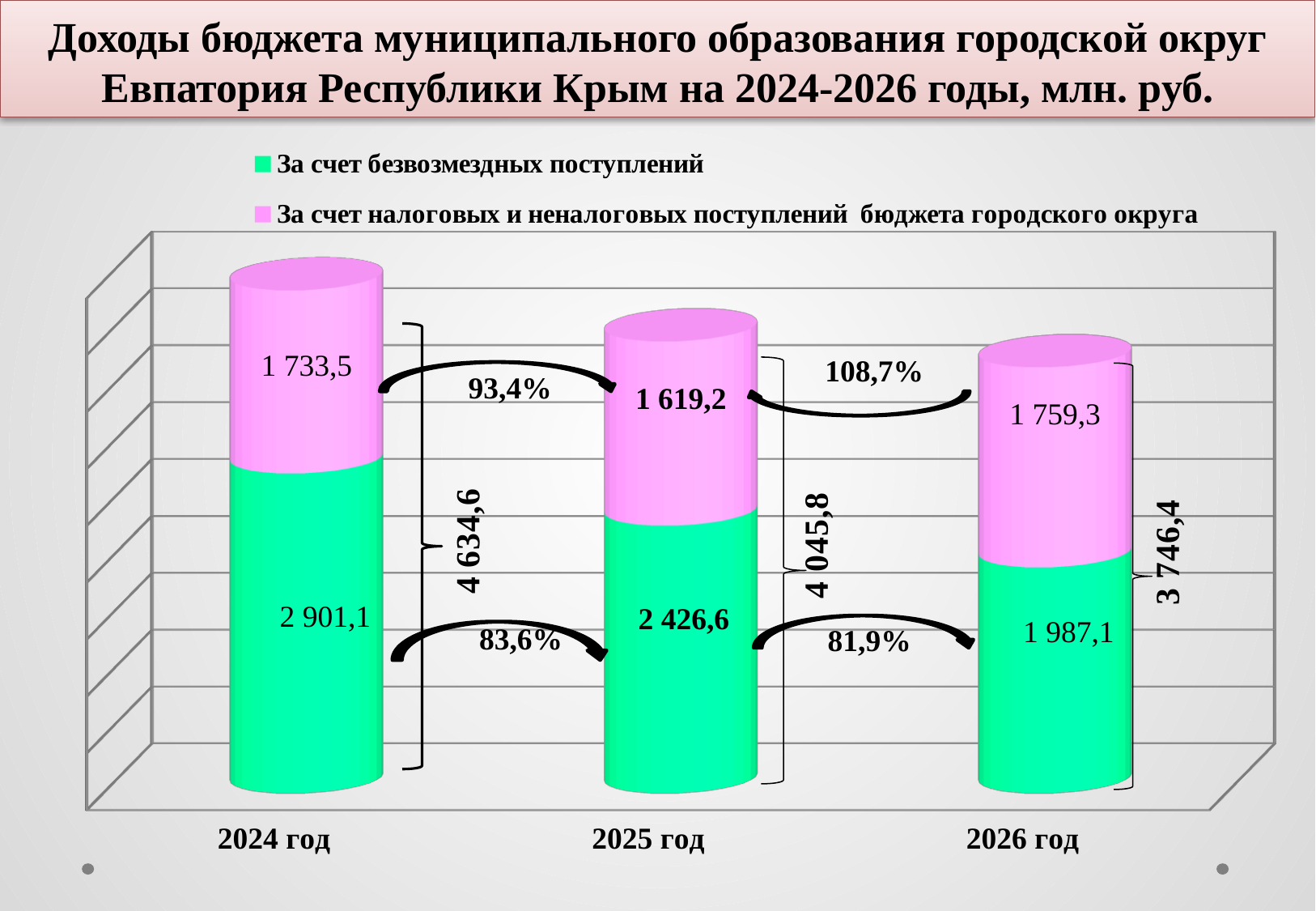
What is the total of the stacked bar for 2026 год? 3 746,4 In which year is the value for «За счет безвозмездных поступлений» highest? 2024 год What is the value for «За счет безвозмездных поступлений» in 2024 год? 2 901,1 What is the total of the stacked bar for 2025 год? 4 045,8 In which year is the total budget income lowest? 2026 год Do the total budget incomes rise or fall from 2024 год to 2026 год? fall How many years are shown on the x axis? 3 What is the difference between the «За счет безвозмездных поступлений» values for 2024 год and 2025 год? 474,5 What is the value for «За счет безвозмездных поступлений» in 2026 год? 1 987,1 What is the value for «За счет налоговых и неналоговых поступлений бюджета городского округа» in 2025 год? 1 619,2 Which is larger: «За счет безвозмездных поступлений» in 2025 год or «За счет налоговых и неналоговых поступлений бюджета городского округа» in 2025 год? За счет безвозмездных поступлений How many series does the legend list? 2